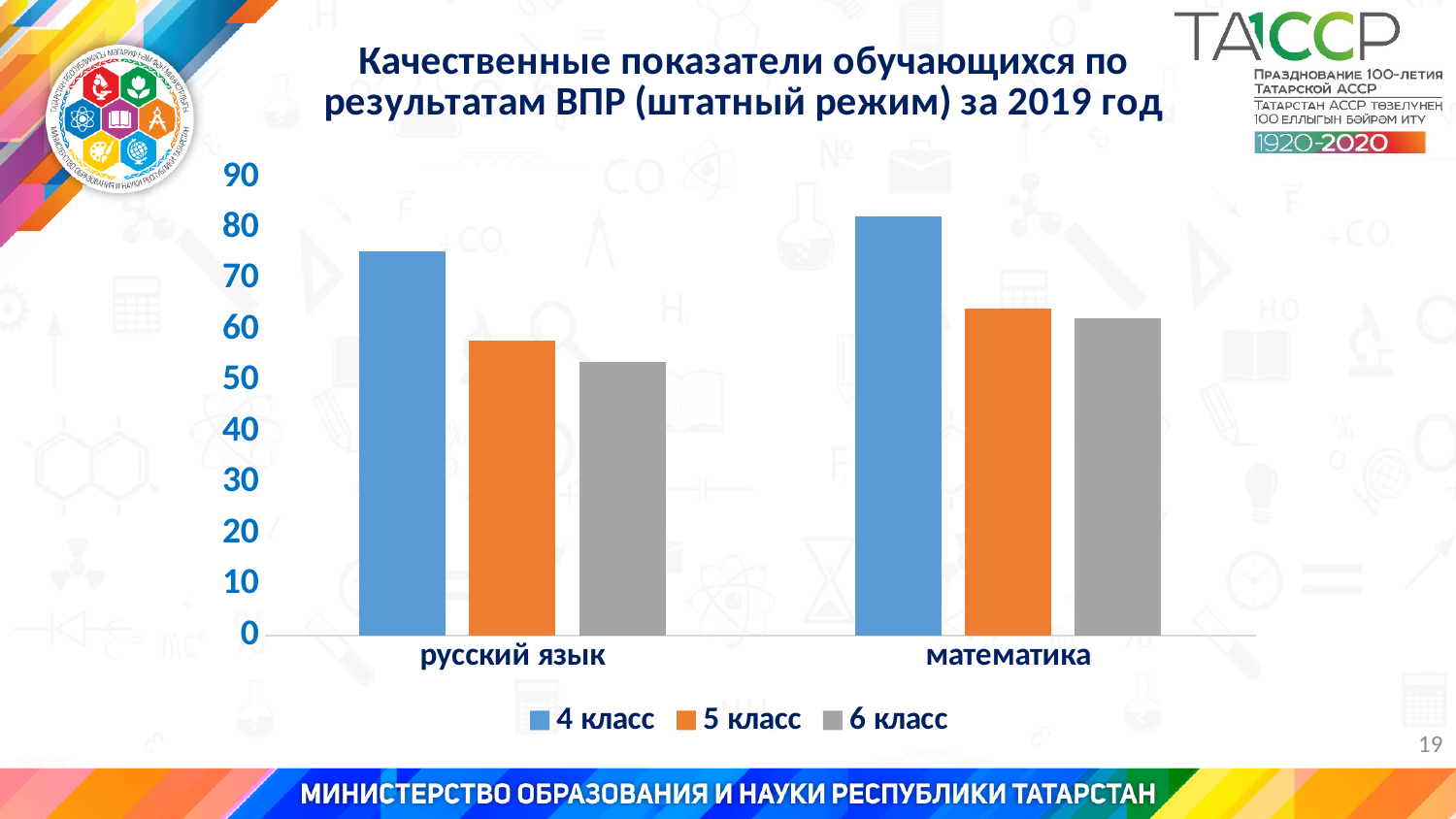
Which is larger: the value for 4 класс in математика or the value for 4 класс in русский язык? 4 класс in математика Which series has the lowest value for русский язык? 6 класс Which colour represents 5 класс in the legend? orange What kind of chart is shown on the slide? bar chart Which series has the highest value for русский язык? 4 класс Is the value for 4 класс in математика greater or less than 70? greater Which series has the highest value for математика? 4 класс How many series does the legend list? 3 How many subject categories are shown on the x axis? 2 Is the value for 4 класс in русский язык greater or less than 70? greater Is the value for 6 класс in математика greater or less than 70? less